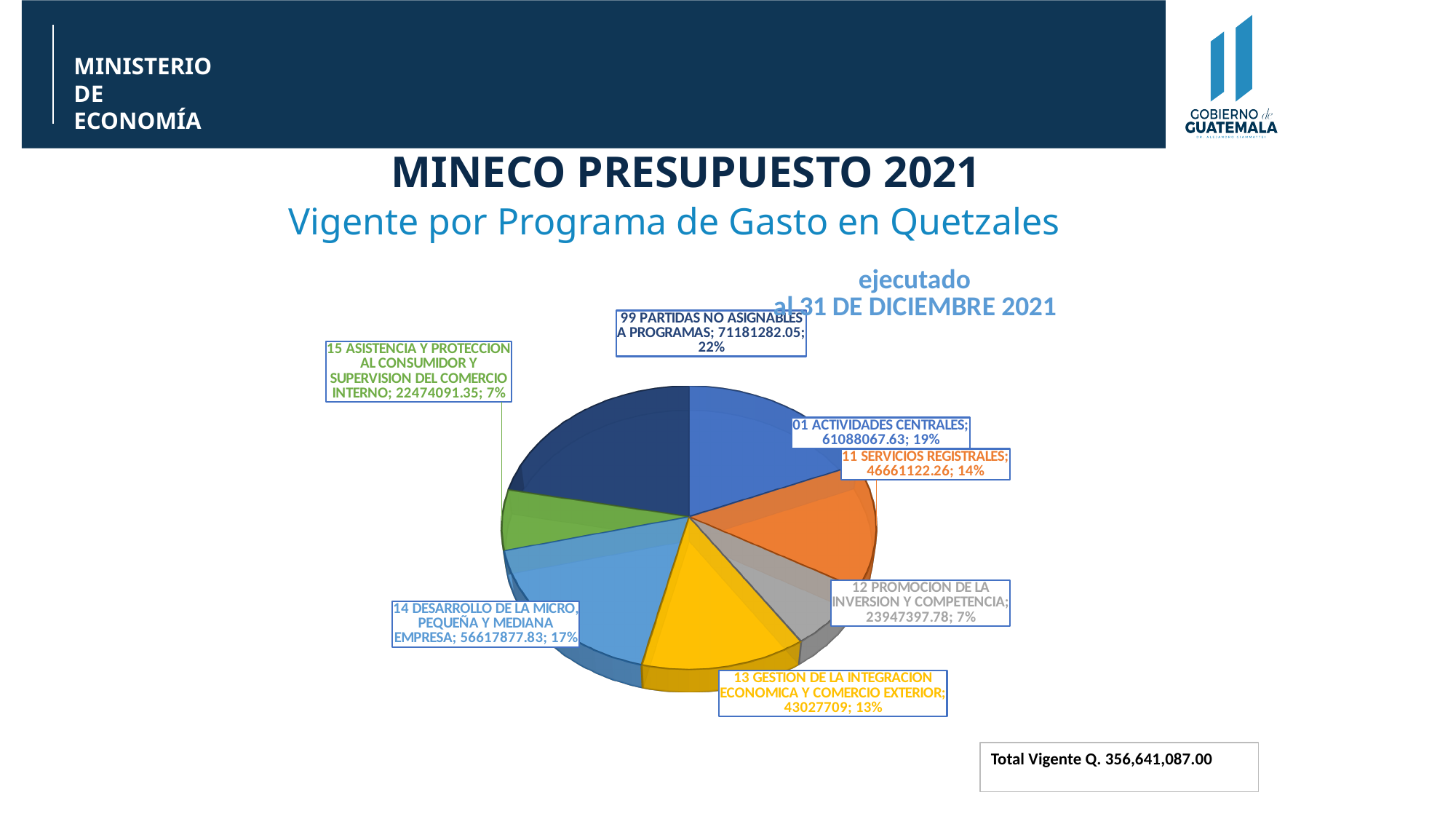
What is the difference between the values for 01 ACTIVIDADES CENTRALES and 11 SERVICIOS REGISTRALES? 14426945.37 What is the main title of the slide above the chart? MINECO PRESUPUESTO 2021 What is the value shown for 01 ACTIVIDADES CENTRALES? 61088067.63 How many slices does the pie chart have? 7 What kind of chart is shown on the slide? Pie chart What is the Total Vigente shown on the slide? Q. 356,641,087.00 What percentage of the pie does 13 GESTION DE LA INTEGRACION ECONOMICA Y COMERCIO EXTERIOR represent? 13% Which program has the largest slice of the pie? 99 PARTIDAS NO ASIGNABLES A PROGRAMAS Which has a larger share: 14 DESARROLLO DE LA MICRO, PEQUEÑA Y MEDIANA EMPRESA or 11 SERVICIOS REGISTRALES? 14 DESARROLLO DE LA MICRO, PEQUEÑA Y MEDIANA EMPRESA Which program has the smallest value in the pie chart? 15 ASISTENCIA Y PROTECCION AL CONSUMIDOR Y SUPERVISION DEL COMERCIO INTERNO What percentage is shown for 12 PROMOCION DE LA INVERSION Y COMPETENCIA? 7% What is the value shown for 14 DESARROLLO DE LA MICRO, PEQUEÑA Y MEDIANA EMPRESA? 56617877.83